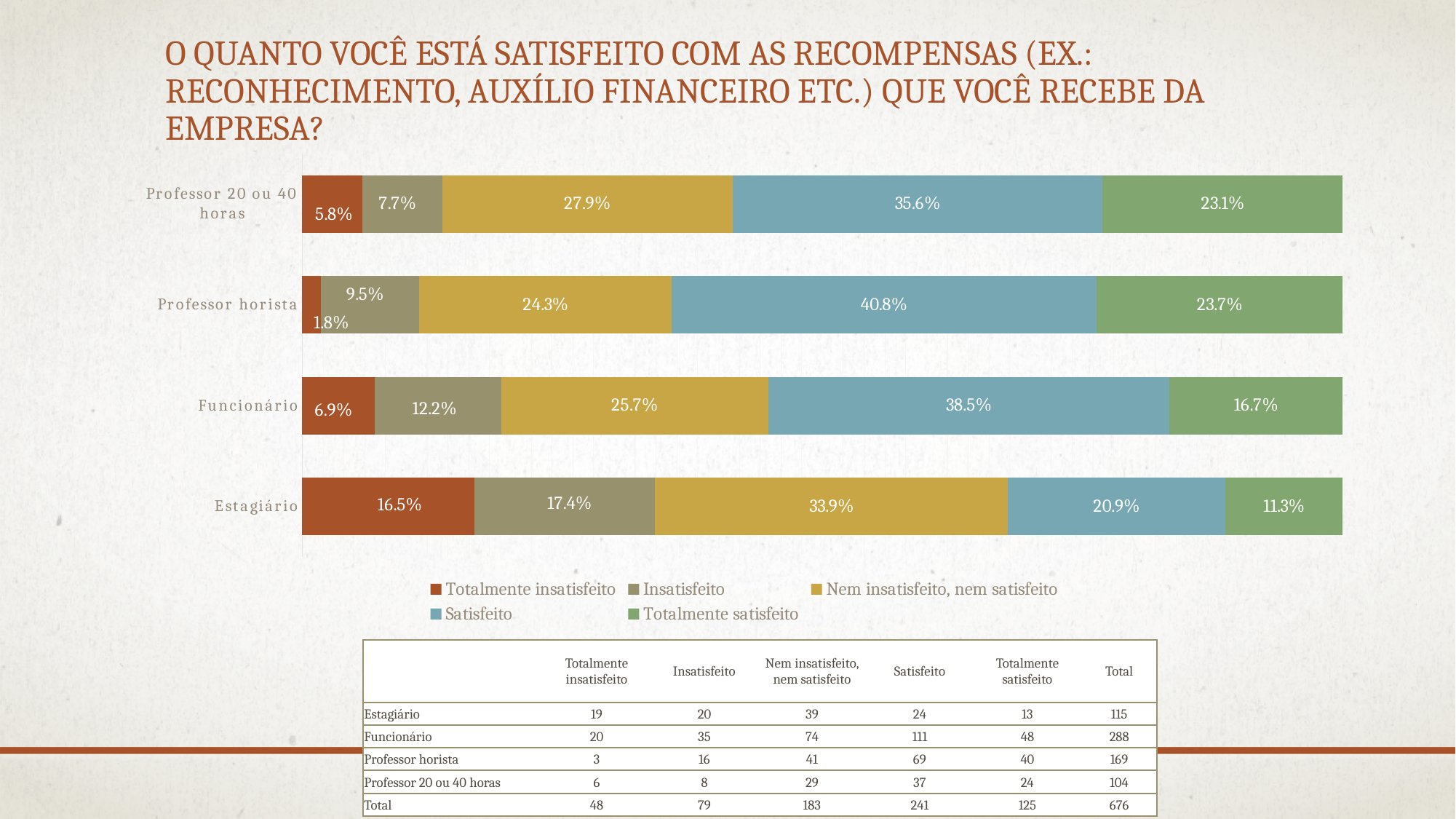
Which category has the highest Totalmente satisfeito percentage? Professor horista Which category has the lowest Totalmente insatisfeito percentage? Professor horista How many categories (groups) are shown on the chart? 4 How many series does the legend list? 5 What is the Totalmente insatisfeito value for Estagiário? 16.5% Which has a larger Nem insatisfeito, nem satisfeito share: Estagiário or Funcionário? Estagiário What colour represents Satisfeito in the legend? Blue What percentage of Professor horista respondents answered Satisfeito? 40.8% What kind of chart is shown on the slide? Stacked bar chart Which response has the largest share for Funcionário? Satisfeito What is the Insatisfeito value for Funcionário? 12.2% What is the difference between the Satisfeito values for Professor horista and Estagiário? 19.9 percentage points